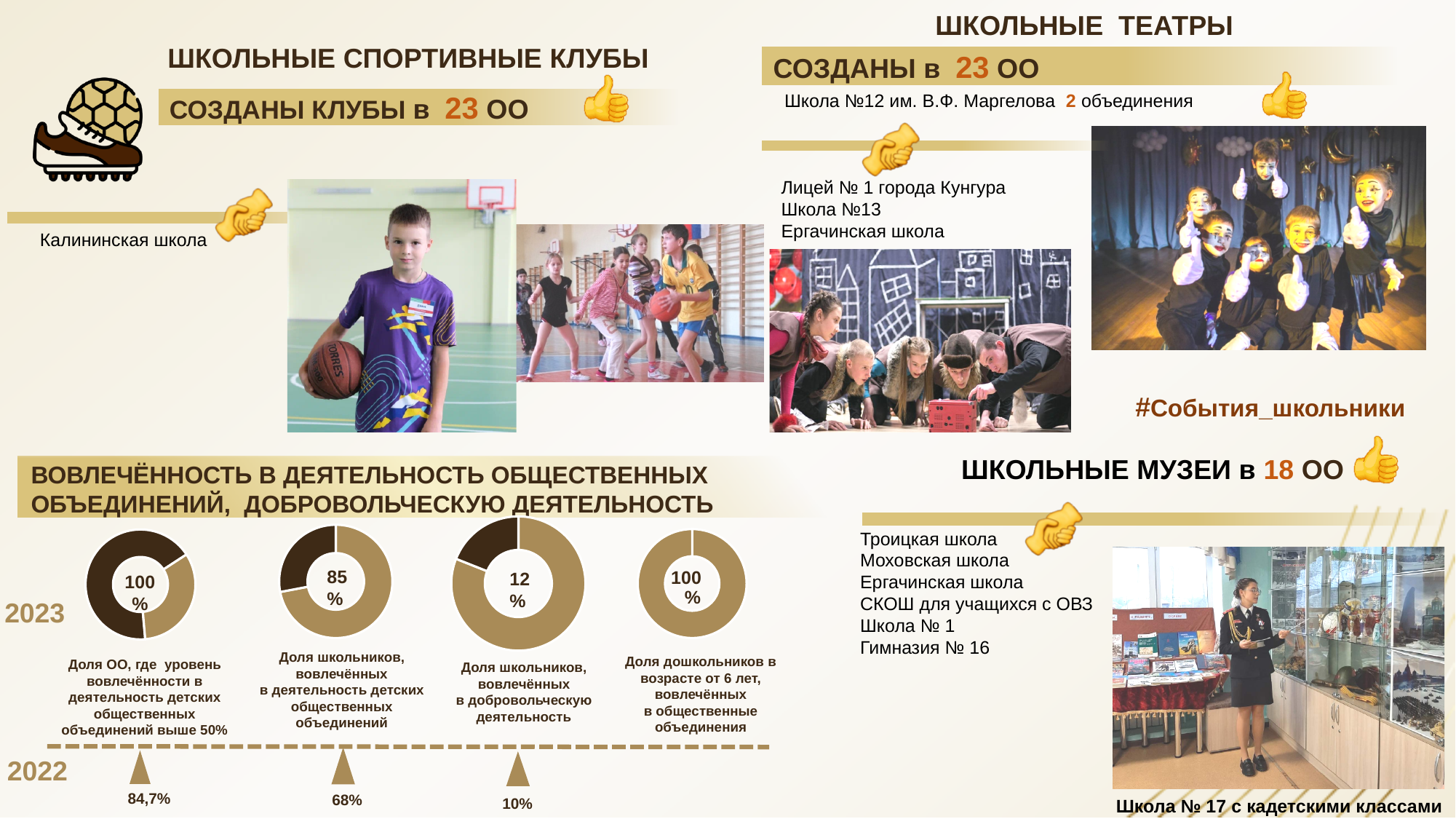
Below the first donut chart (Доля ОО, где уровень вовлечённости выше 50%), what value is given for 2022? 84,7% In the donut chart for 'Доля ОО, где уровень вовлечённости в деятельность детских общественных объединений выше 50%', what value is shown for 2023? 100% For 'Доля школьников, вовлечённых в деятельность детских общественных объединений', by how many percentage points did the value change from 2022 (68%) to 2023 (85%)? 17 percentage points In the donut chart for 'Доля дошкольников в возрасте от 6 лет, вовлечённых в общественные объединения', what value is shown for 2023? 100% In the donut chart for 'Доля школьников, вовлечённых в деятельность детских общественных объединений', what value is shown for 2023? 85% Among the four donut charts, which indicator has the lowest 2023 value? Доля школьников, вовлечённых в добровольческую деятельность Below the second donut chart (Доля школьников, вовлечённых в деятельность детских общественных объединений), what value is given for 2022? 68% How many donut charts are shown in the 'ВОВЛЕЧЁННОСТЬ В ДЕЯТЕЛЬНОСТЬ ОБЩЕСТВЕННЫХ ОБЪЕДИНЕНИЙ' section? 4 For 'Доля школьников, вовлечённых в деятельность детских общественных объединений', which year has the larger value, 2022 or 2023? 2023 In the donut chart for 'Доля школьников, вовлечённых в добровольческую деятельность', what value is shown for 2023? 12% What kind of chart is used to show the 2023 involvement shares in the bottom-left section? Pie (donut) chart Below the third donut chart (Доля школьников, вовлечённых в добровольческую деятельность), what value is given for 2022? 10%